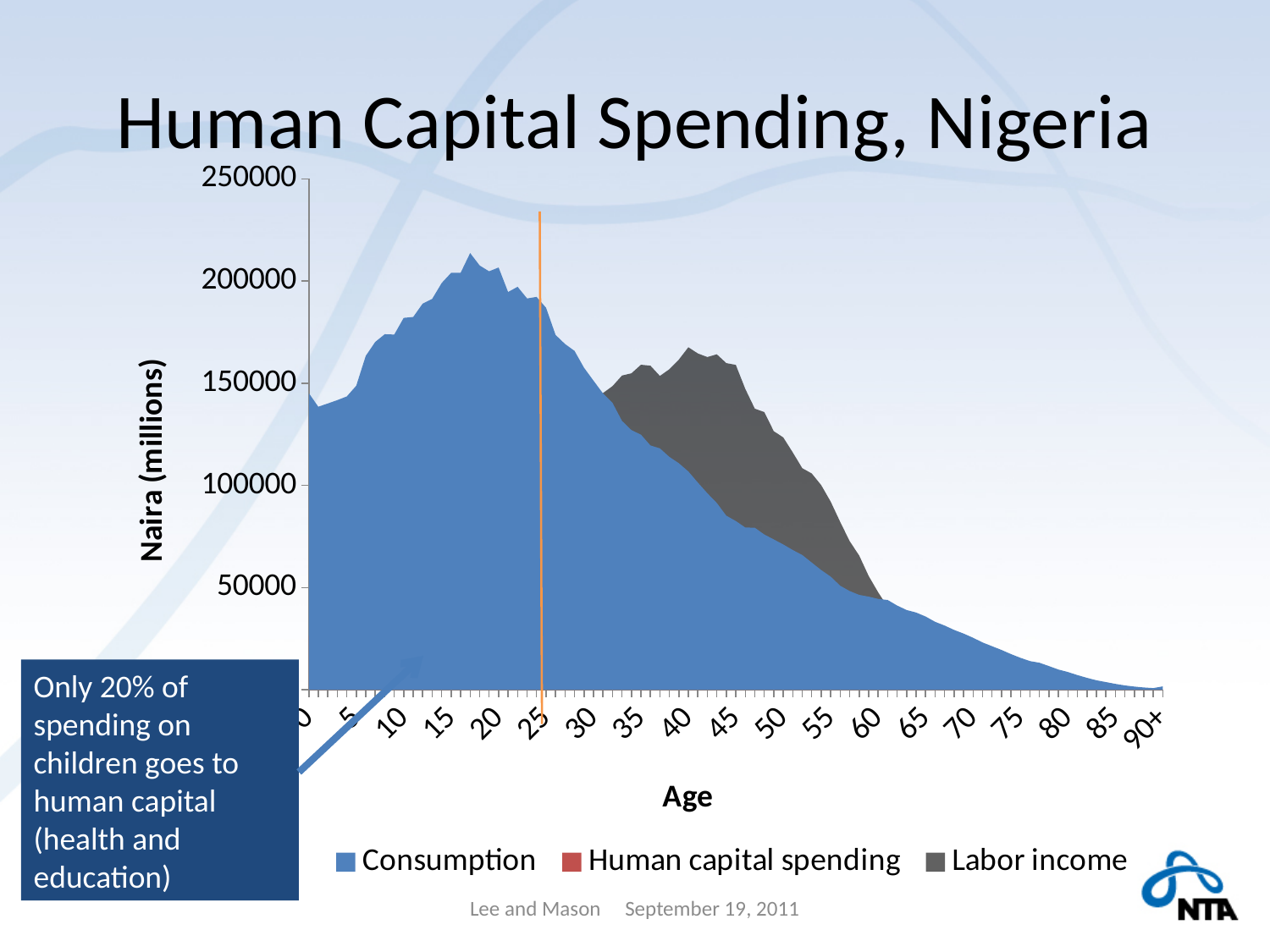
What is the title of the chart? Human Capital Spending, Nigeria What is the label of the vertical axis? Naira (millions) Is the value for Labor income at age 55 greater or less than 150000? less What kind of chart is shown on the slide? Area chart Which is larger, Labor income at age 40 or Labor income at age 55? Labor income at age 40 Is the value for Labor income at age 40 greater or less than 150000? greater How many series does the legend list? 3 Does Consumption rise or fall along the x axis from age 25 to age 90+? Fall How many age tick labels are shown on the x axis? 19 Which is larger, Consumption at age 15 or Consumption at age 50? Consumption at age 15 Is the value for Consumption at age 15 greater or less than 150000? greater